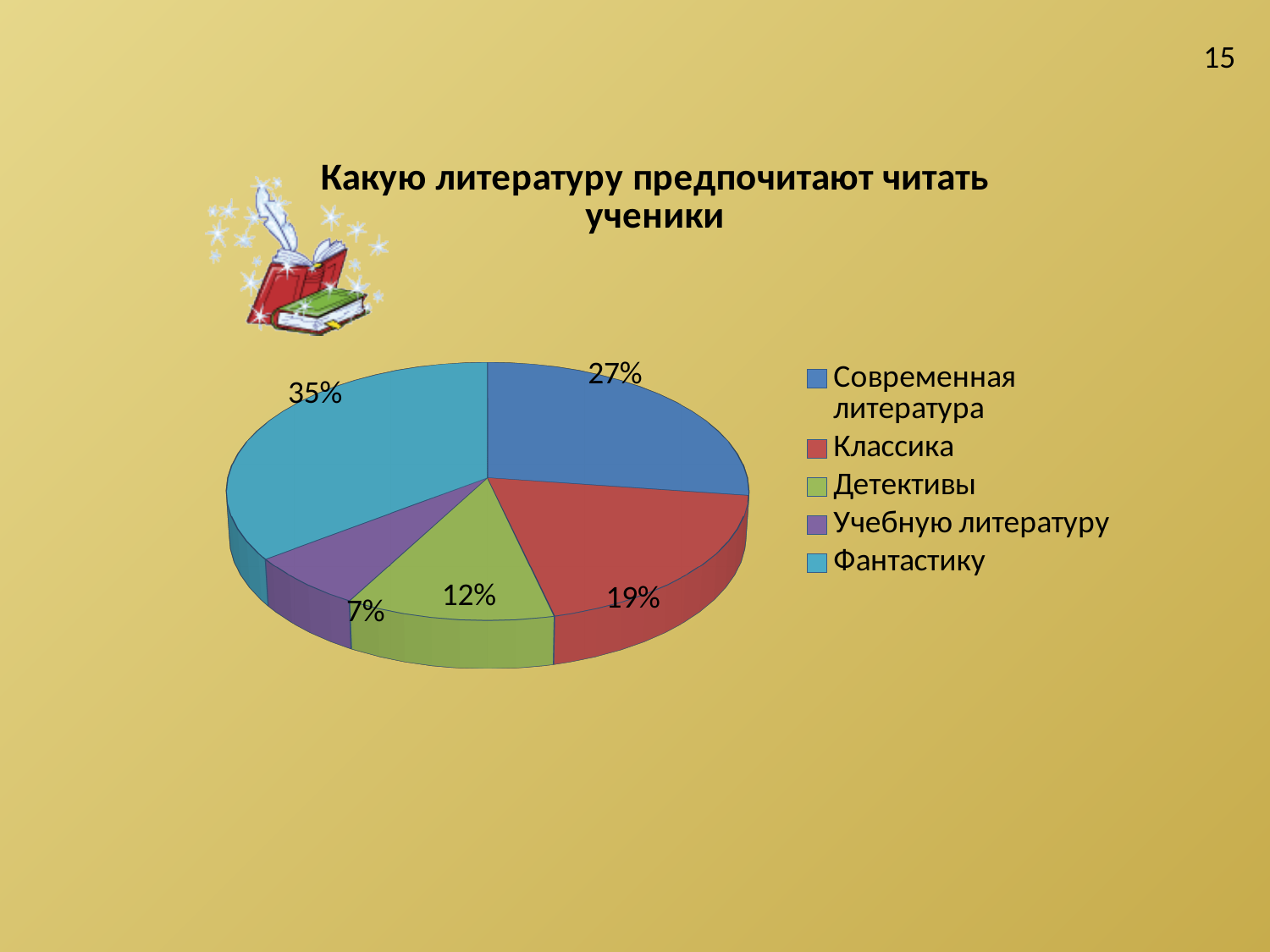
What share of the pie does Современная литература have? 27% What share of the pie does Детективы have? 12% Which category has the largest slice of the pie? Фантастику What kind of chart is shown on the slide? Pie chart What is the title of the chart? Какую литературу предпочитают читать ученики Which is larger, the share for Современная литература or the share for Детективы? Современная литература What share of the pie does Классика have? 19% How many categories does the pie chart show? 5 What share of the pie does Учебную литературу have? 7% Which category has the smallest slice of the pie? Учебную литературу What share of the pie does Фантастику have? 35% What is the difference between the shares for Фантастику and Классика? 16%